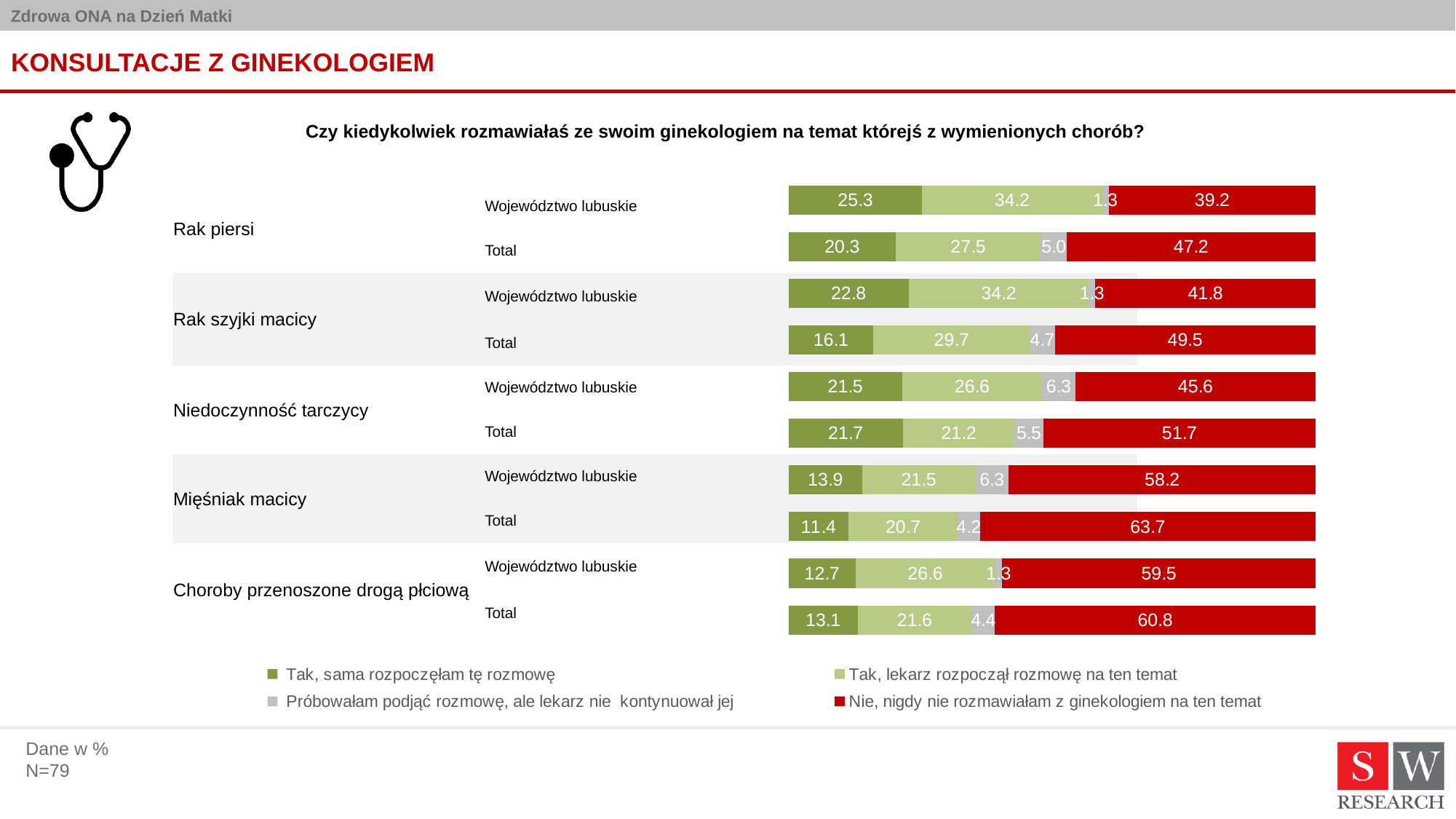
How many bars are plotted in the chart? 10 What is the value of 'Tak, sama rozpoczęłam tę rozmowę' for Rak szyjki macicy, Total? 16.1 What kind of chart is shown on the slide? Stacked bar chart What is the value of 'Próbowałam podjąć rozmowę, ale lekarz nie kontynuował jej' for Mięśniak macicy, Total? 4.2 Which is larger: the 'Tak, sama rozpoczęłam tę rozmowę' value for Choroby przenoszone drogą płciową Województwo lubuskie or Total? Total What is the total of the stacked bar for Rak piersi, Total? 100.0 Which bar has the highest value for 'Tak, sama rozpoczęłam tę rozmowę'? Rak piersi, Województwo lubuskie How many series does the legend list? 4 What is the value of 'Nie, nigdy nie rozmawiałam z ginekologiem na ten temat' for Rak piersi, Województwo lubuskie? 39.2 What is the value of 'Tak, lekarz rozpoczął rozmowę na ten temat' for Niedoczynność tarczycy, Województwo lubuskie? 26.6 Which bar has the highest value for 'Nie, nigdy nie rozmawiałam z ginekologiem na ten temat'? Mięśniak macicy, Total What is the difference between the 'Nie, nigdy nie rozmawiałam' values for Rak piersi Total and Rak piersi Województwo lubuskie? 8.0